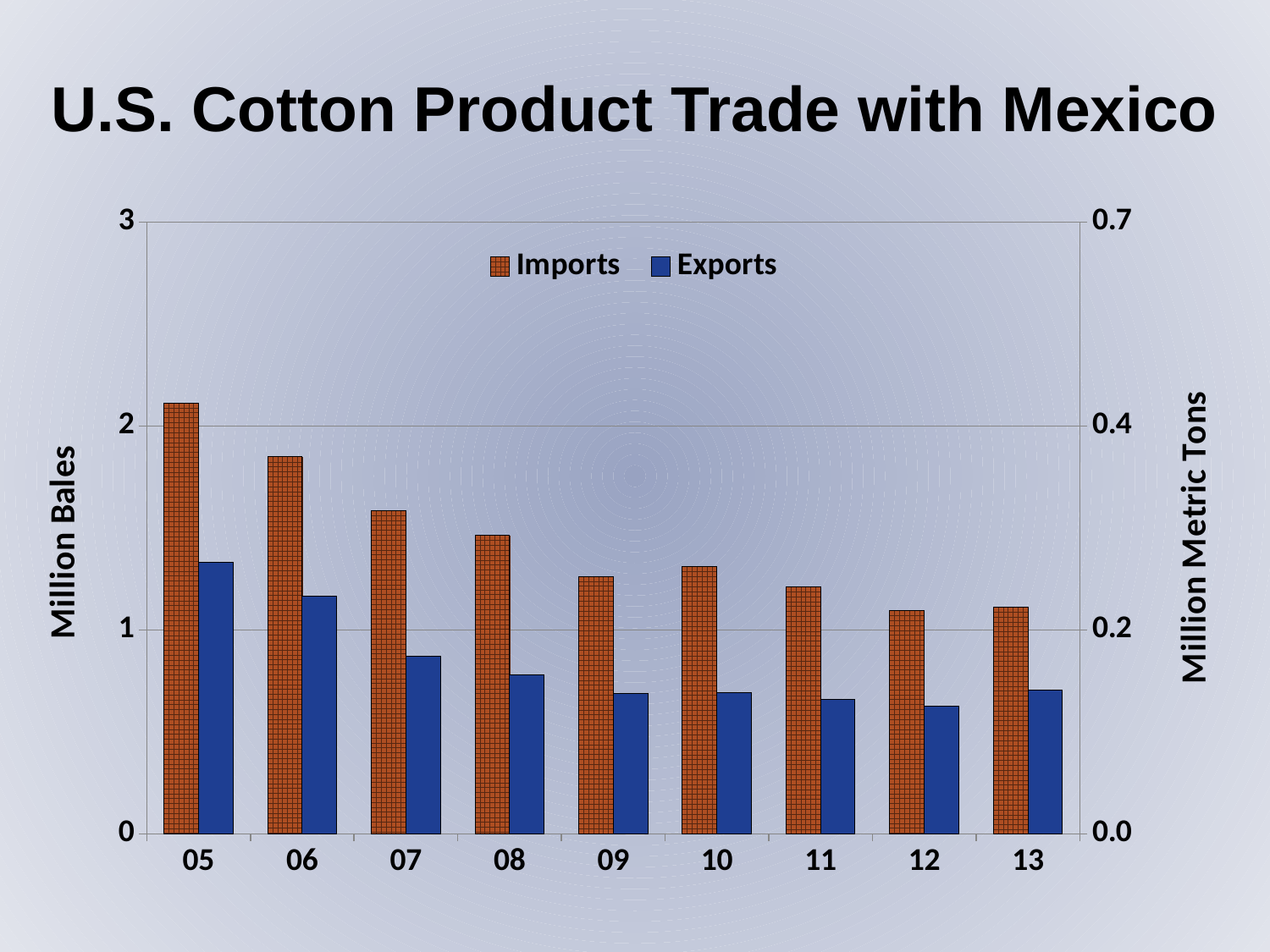
Is the Exports value for 05 greater or less than 1? greater Is the Exports value for 07 greater or less than 1? less Is the Imports value for 06 greater or less than 2? less Do Imports generally rise or fall from 05 to 13? Fall Which is larger, Imports in 05 or Imports in 13? Imports in 05 In which year are Exports highest? 05 How many series does the legend list? 2 How many years are shown on the x axis? 9 What kind of chart is shown on the slide? Bar chart In which year are Imports highest? 05 What is the title of the chart? U.S. Cotton Product Trade with Mexico